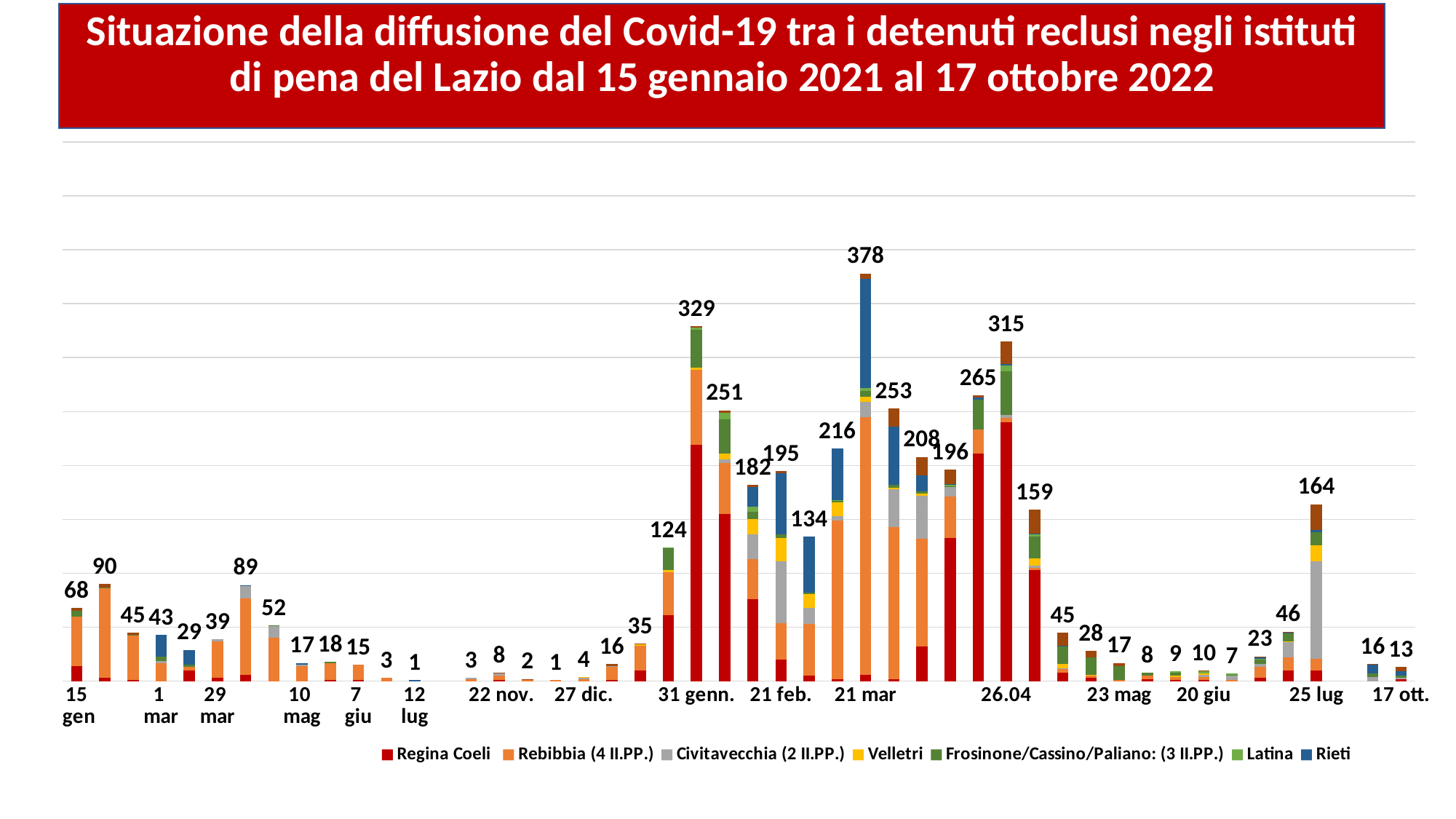
Which series is shown in red in the legend? Regina Coeli What is the total value shown for 25 lug? 164 Which has the larger total, 31 genn. or 21 mar? 21 mar What is the total value shown for 17 ott.? 13 What is the difference between the totals for 21 mar (378) and 31 genn. (329)? 49 What is the total value shown for 31 genn.? 329 What is the highest total shown on the chart? 378 How many series does the legend list? 7 On which date does the chart reach its highest total? 21 mar What is the total value shown for 15 gen? 68 Do the totals rise or fall overall from 15 gen to 12 lug? Fall What kind of chart is shown on the slide? Stacked bar chart